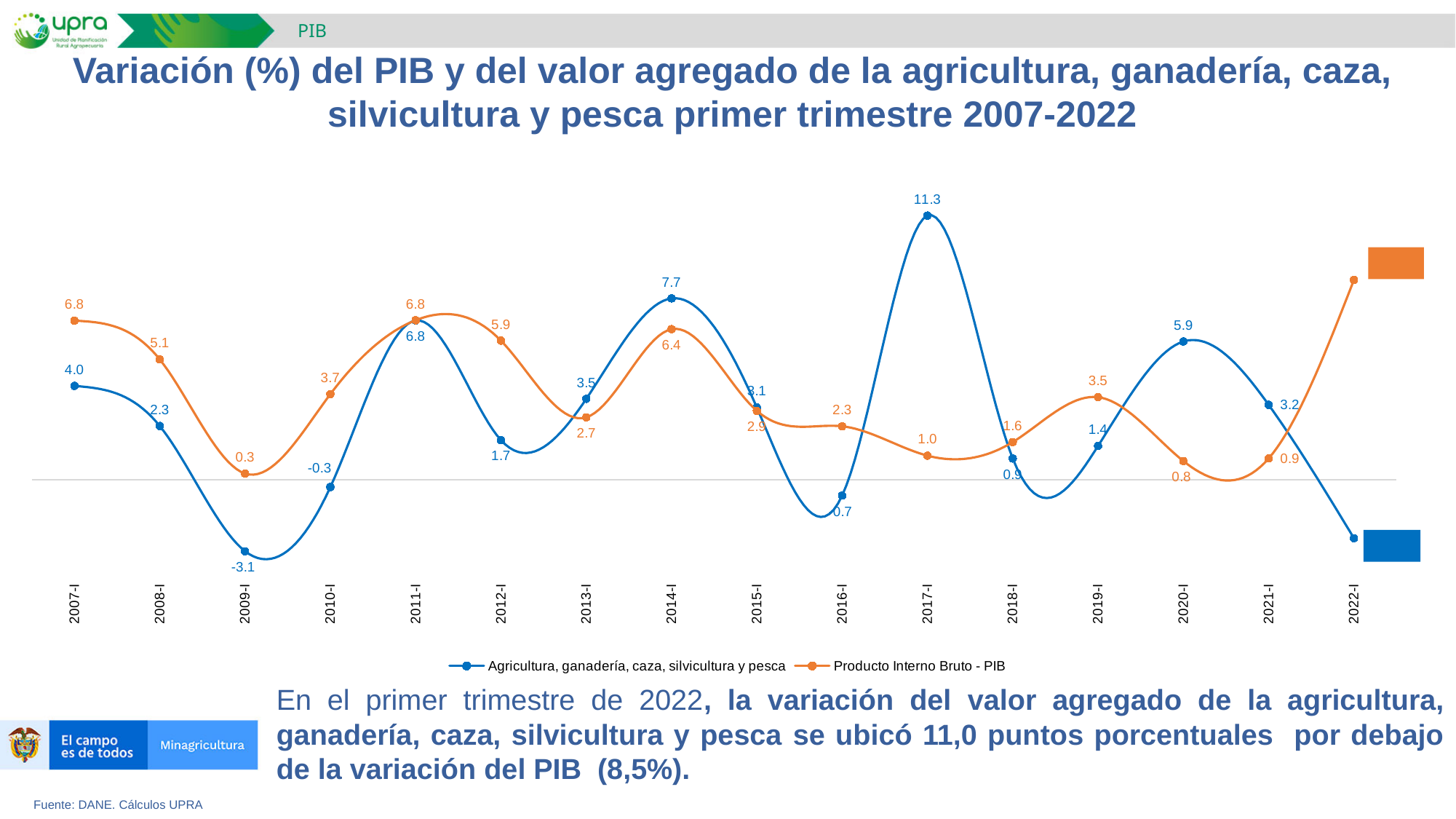
What kind of chart is shown on the slide? Line chart How many periods are shown on the x axis? 16 In which period does the Producto Interno Bruto - PIB series have its lowest labelled value? 2009-I In which period does the Agricultura, ganadería, caza, silvicultura y pesca series reach its lowest value? 2009-I What is the value for Producto Interno Bruto - PIB in 2012-I? 5.9 What is the value for Agricultura, ganadería, caza, silvicultura y pesca in 2009-I? -3.1 What is the difference between the Agricultura value and the PIB value in 2017-I? 10.3 In 2014-I, which series has the larger value, Agricultura or PIB? Agricultura, ganadería, caza, silvicultura y pesca Does the Agricultura series rise or fall from 2017-I to 2018-I? Fall How many series does the legend list? 2 What is the value for Agricultura, ganadería, caza, silvicultura y pesca in 2017-I? 11.3 In which period does the Agricultura, ganadería, caza, silvicultura y pesca series reach its highest value? 2017-I